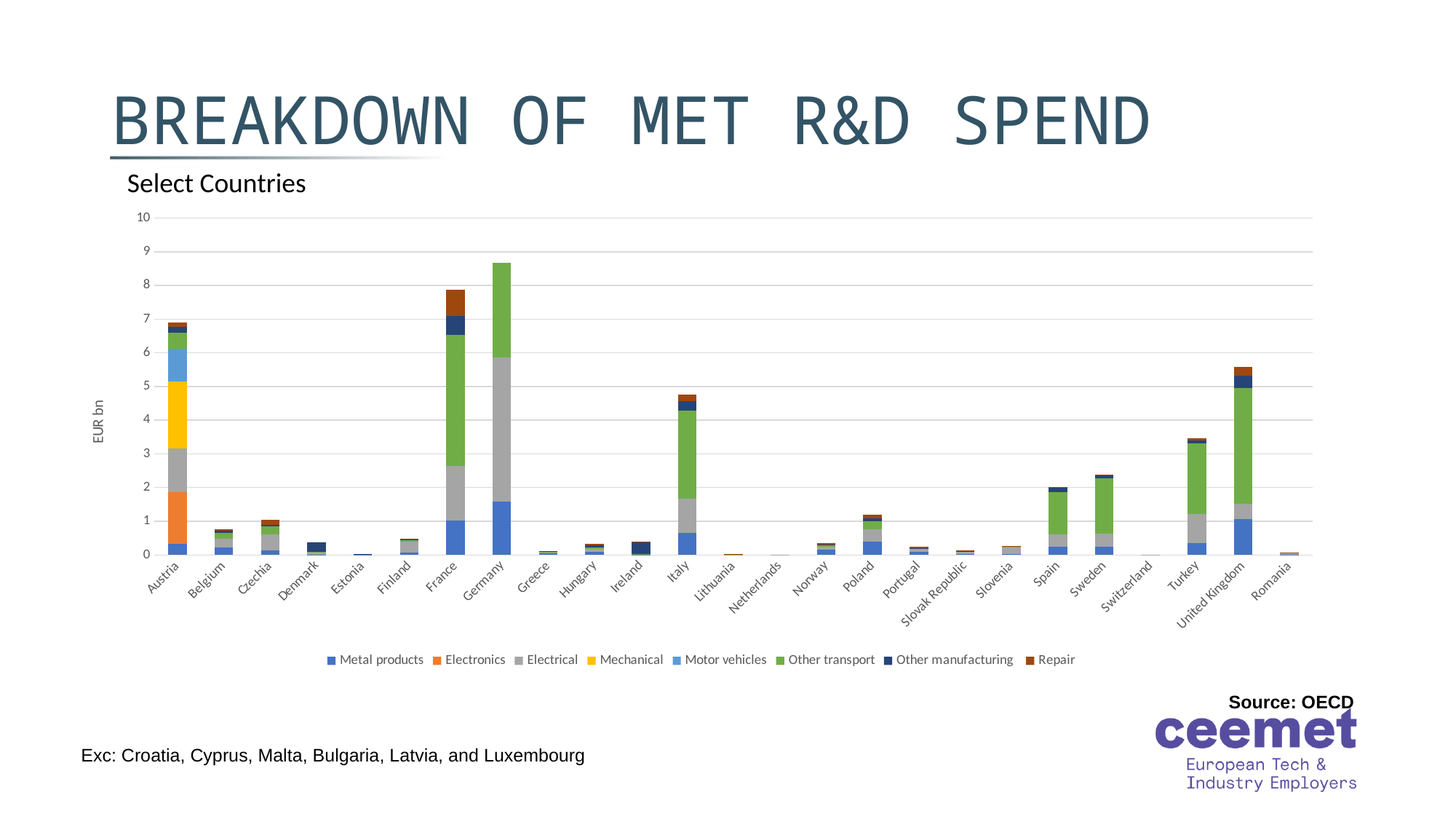
Which has the larger total MET R&D spend, France or Germany? Germany Is the total value for Italy greater or less than 5? less What kind of chart is shown on the slide? Stacked bar chart Is the total value for the United Kingdom greater or less than 5? greater Which country has the highest total MET R&D spend in the chart? Germany How many countries are shown on the x axis of the chart? 25 What unit is shown on the y axis of the chart? EUR bn Is the total value for Turkey greater or less than 4? less Which has the larger total MET R&D spend, Turkey or Sweden? Turkey How many series does the chart's legend list? 8